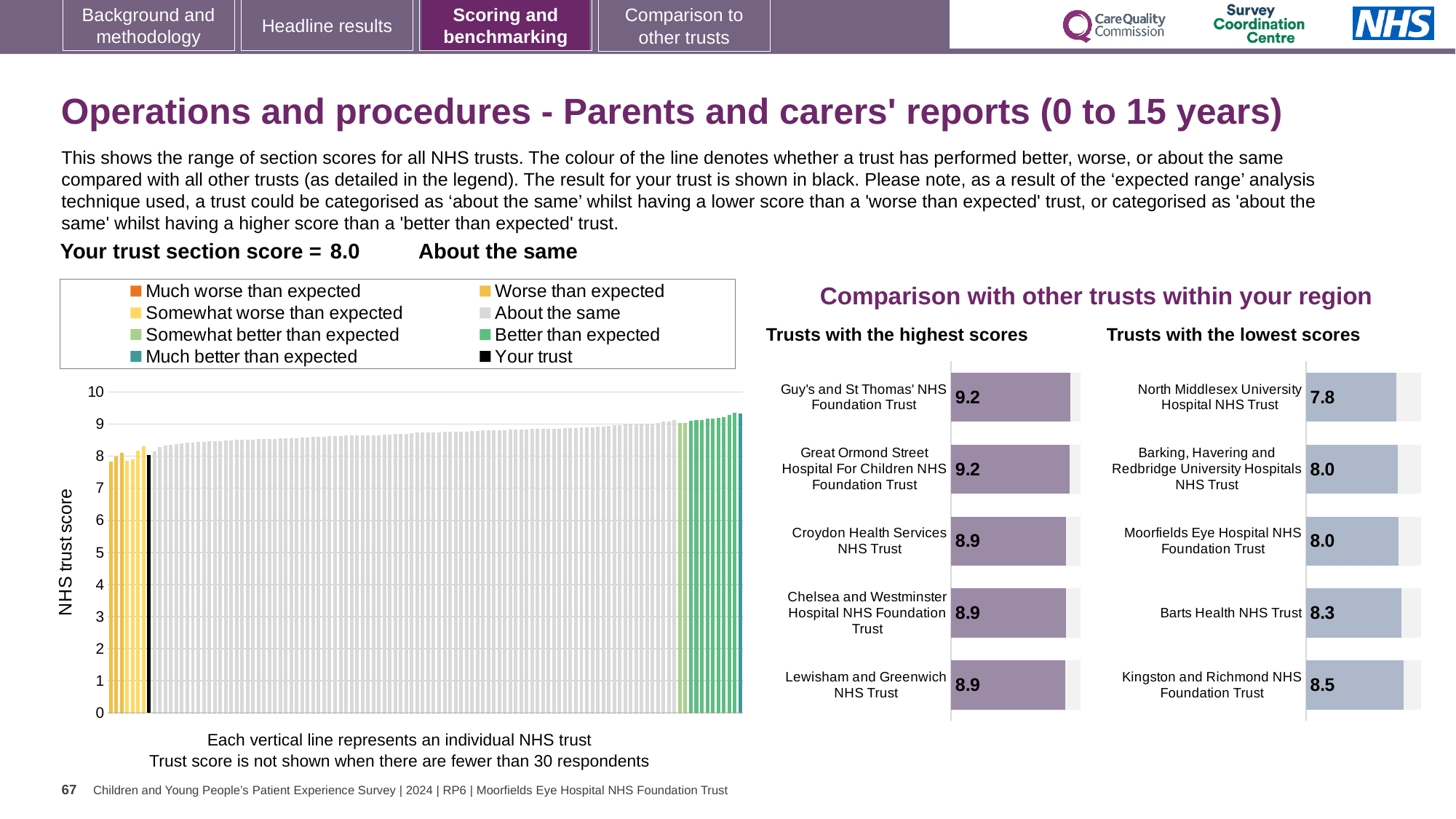
In the 'Trusts with the lowest scores' chart, what is the difference between the scores of Kingston and Richmond NHS Foundation Trust and North Middlesex University Hospital NHS Trust? 0.7 How many trusts are shown in the 'Trusts with the highest scores' chart? 5 In the 'Trusts with the highest scores' chart, what is the difference between the scores of Guy's and St Thomas' NHS Foundation Trust and Lewisham and Greenwich NHS Trust? 0.3 In the 'Trusts with the lowest scores' chart, what is the score for North Middlesex University Hospital NHS Trust? 7.8 In the 'Trusts with the lowest scores' chart, which trust has the highest score? Kingston and Richmond NHS Foundation Trust In the 'Trusts with the lowest scores' chart, which has the larger score: Barts Health NHS Trust or Moorfields Eye Hospital NHS Foundation Trust? Barts Health NHS Trust In the 'Trusts with the lowest scores' chart, what is the score for Barts Health NHS Trust? 8.3 In the 'Trusts with the highest scores' chart, what is the score for Guy's and St Thomas' NHS Foundation Trust? 9.2 In the 'Trusts with the lowest scores' chart, which trust has the lowest score? North Middlesex University Hospital NHS Trust In the 'Trusts with the highest scores' chart, what is the score for Croydon Health Services NHS Trust? 8.9 In the left chart of NHS trust scores, is the value for the black 'Your trust' bar greater or less than 5? greater What kind of chart is the left chart showing NHS trust scores? Bar chart